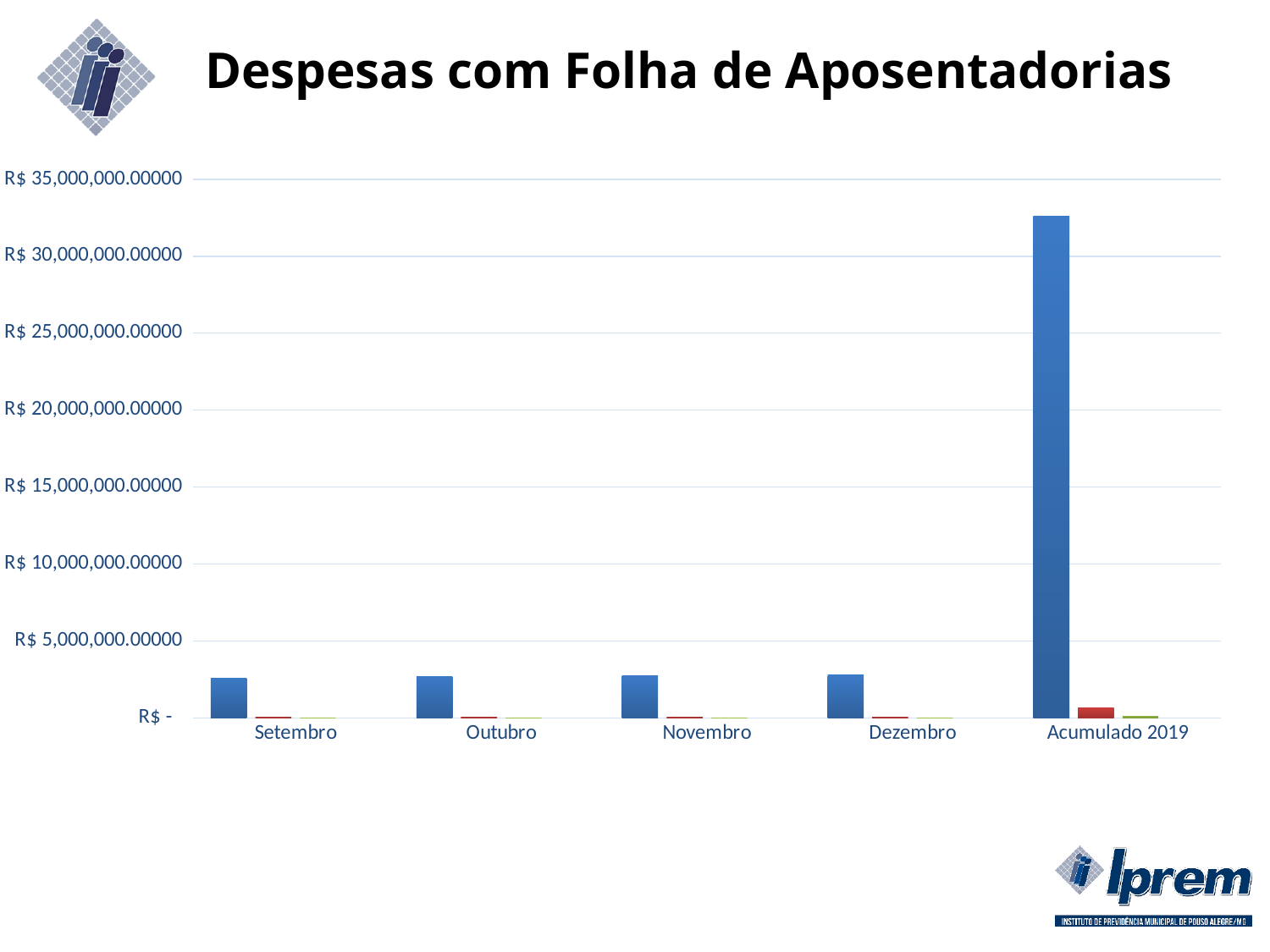
Which has a larger blue bar, Novembro or Acumulado 2019? Acumulado 2019 How many bars are plotted for each category in the chart? 3 Which category is the last one on the x axis of the chart? Acumulado 2019 Which category has the tallest bar in the chart? Acumulado 2019 Is the value of the blue bar for Acumulado 2019 greater or less than R$ 35,000,000.00000? less What is the title of the chart? Despesas com Folha de Aposentadorias How many categories are shown on the x axis of the chart? 5 Is the value of the blue bar for Acumulado 2019 greater or less than R$ 30,000,000.00000? greater Is the value of the blue bar for Dezembro greater or less than R$ 5,000,000.00000? less What is the highest value labelled on the y axis of the chart? R$ 35,000,000.00000 What type of chart is shown on the slide? bar chart